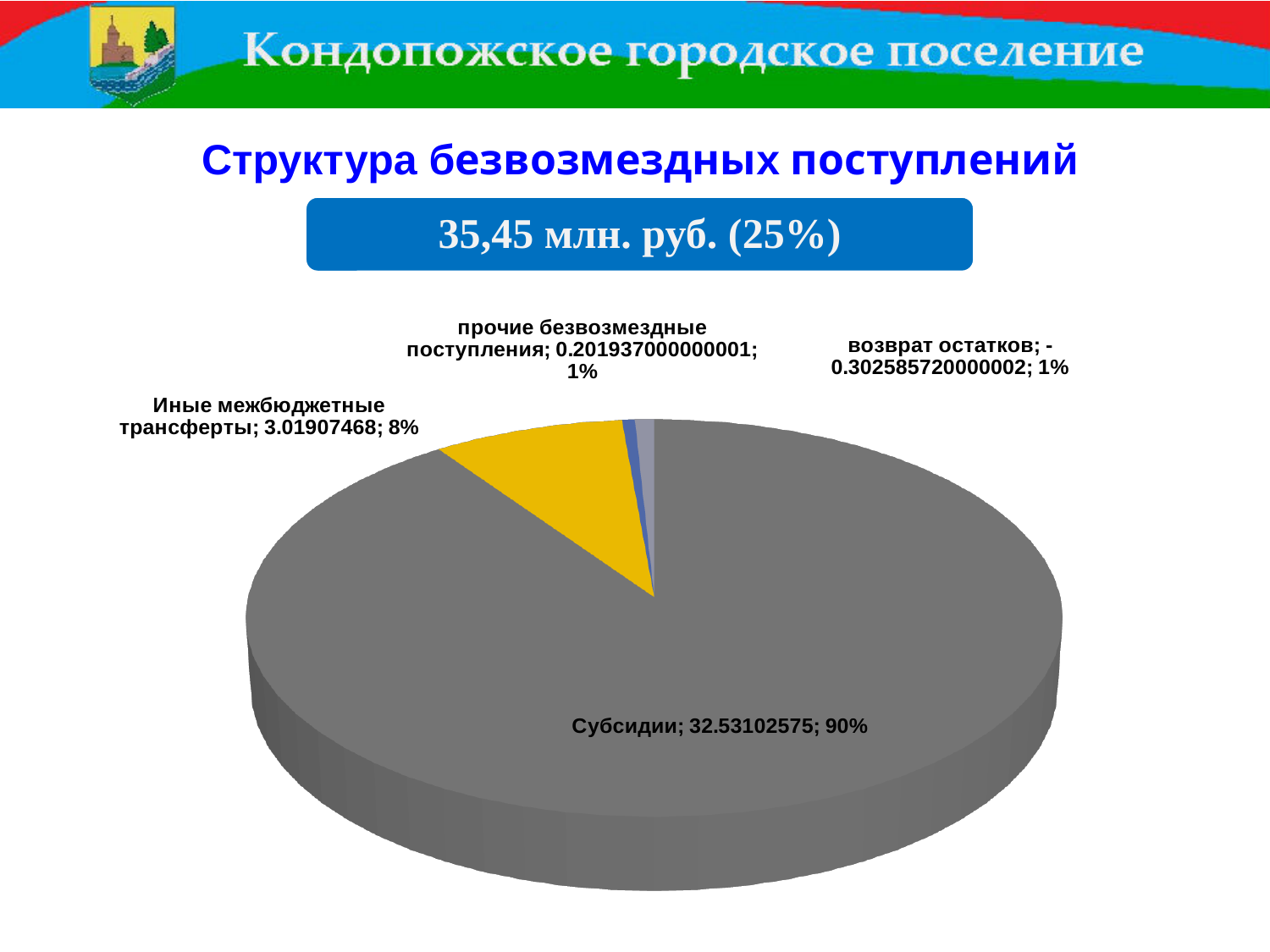
What is the value shown for прочие безвозмездные поступления? 0.201937000000001 What is the value shown for Иные межбюджетные трансферты? 3.01907468 What is the value shown for Субсидии? 32.53102575 Which is larger, the value for Иные межбюджетные трансферты or the value for прочие безвозмездные поступления? Иные межбюджетные трансферты How many categories (slices) does the pie chart have? 4 What kind of chart is shown on the slide? pie chart What is the difference between the values for Субсидии and Иные межбюджетные трансферты? 29.51195107 What share of the pie does Иные межбюджетные трансферты represent? 8% What share of the pie does Субсидии represent? 90% What is the value shown for возврат остатков? -0.302585720000002 Which category has the largest slice of the pie? Субсидии What is the title of the chart on the slide? Структура безвозмездных поступлений